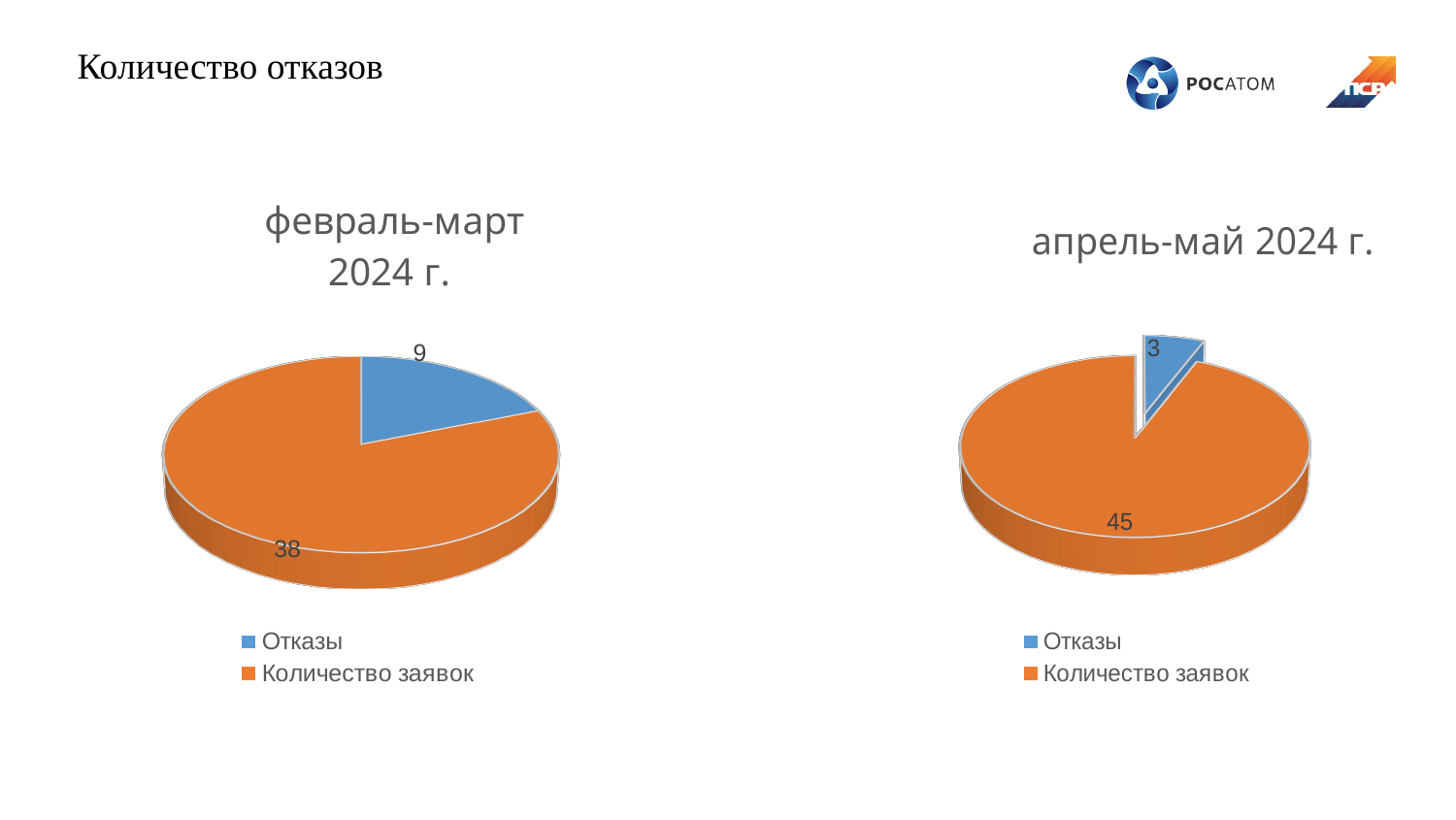
In the chart titled "апрель-май 2024 г.", which category has the smallest slice? Отказы In the chart titled "апрель-май 2024 г.", what is the value for Отказы? 3 In the chart titled "февраль-март 2024 г.", what is the difference between Количество заявок and Отказы? 29 In the chart titled "апрель-май 2024 г.", what is the difference between Количество заявок and Отказы? 42 How many categories does the legend of the chart titled "февраль-март 2024 г." list? 2 In the chart titled "февраль-март 2024 г.", what is the value for Отказы? 9 In the chart titled "февраль-март 2024 г.", what is the value for Количество заявок? 38 What colour is the Отказы slice in the chart titled "апрель-май 2024 г."? blue In the chart titled "апрель-май 2024 г.", what is the value for Количество заявок? 45 In the chart titled "февраль-март 2024 г.", which category has the largest slice? Количество заявок Is the value for Отказы larger in the chart titled "февраль-март 2024 г." or in the chart titled "апрель-май 2024 г."? февраль-март 2024 г. What type of chart is the chart titled "апрель-май 2024 г."? pie chart